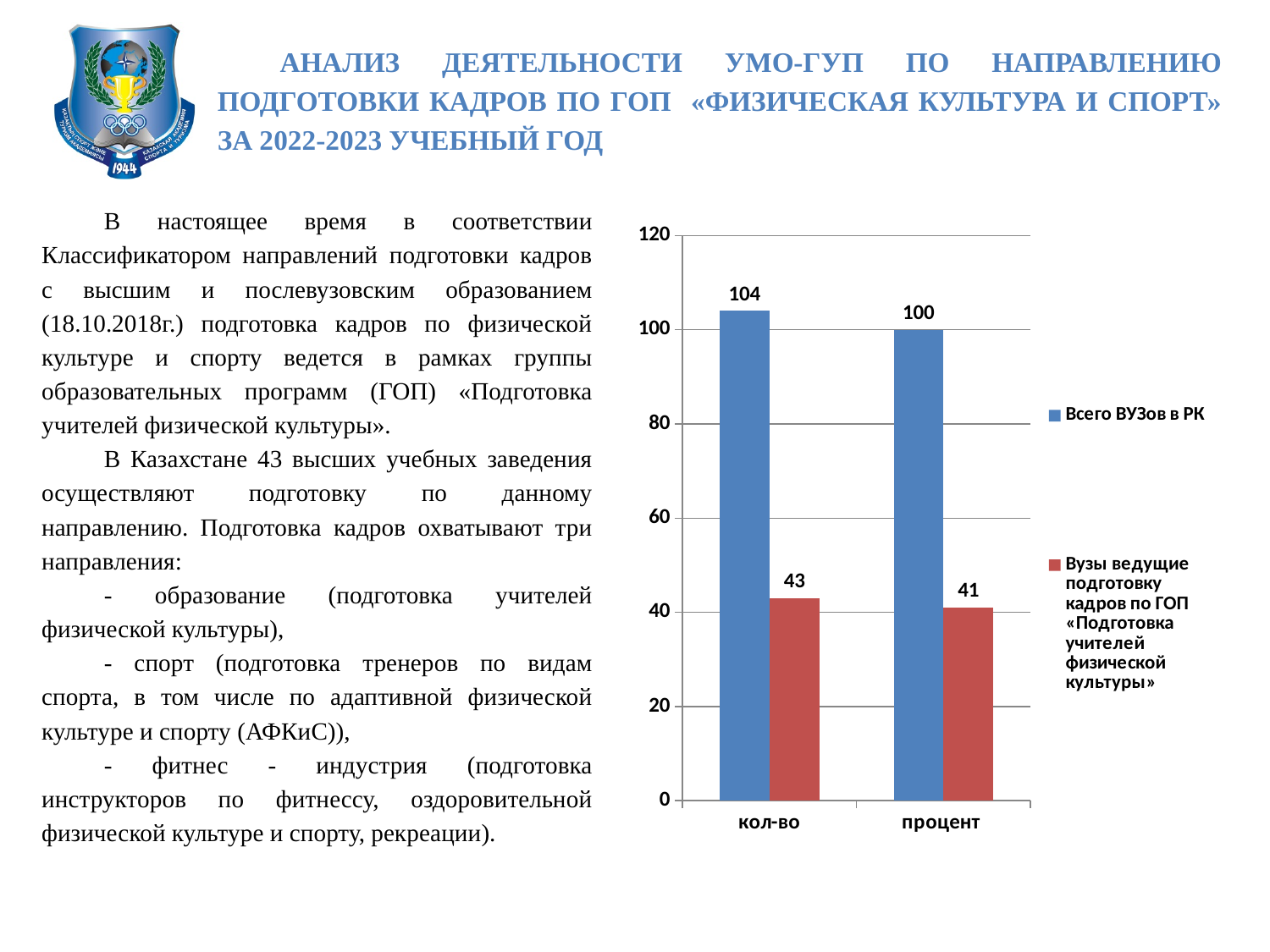
What kind of chart is shown on the slide? bar chart How many categories are shown on the x axis? 2 What is the value for 'Всего ВУЗов в РК' in the 'кол-во' category? 104 Which series has the larger value in the 'процент' category? Всего ВУЗов в РК What colour are the bars for 'Всего ВУЗов в РК'? blue How many series does the legend list? 2 What is the value for 'Всего ВУЗов в РК' in the 'процент' category? 100 What is the value for 'Вузы ведущие подготовку кадров по ГОП «Подготовка учителей физической культуры»' in the 'кол-во' category? 43 Which category has the highest value for 'Всего ВУЗов в РК'? кол-во What is the difference between the two bars in the 'кол-во' category? 61 What is the value for 'Вузы ведущие подготовку кадров по ГОП «Подготовка учителей физической культуры»' in the 'процент' category? 41 What is the difference between the two bars in the 'процент' category? 59